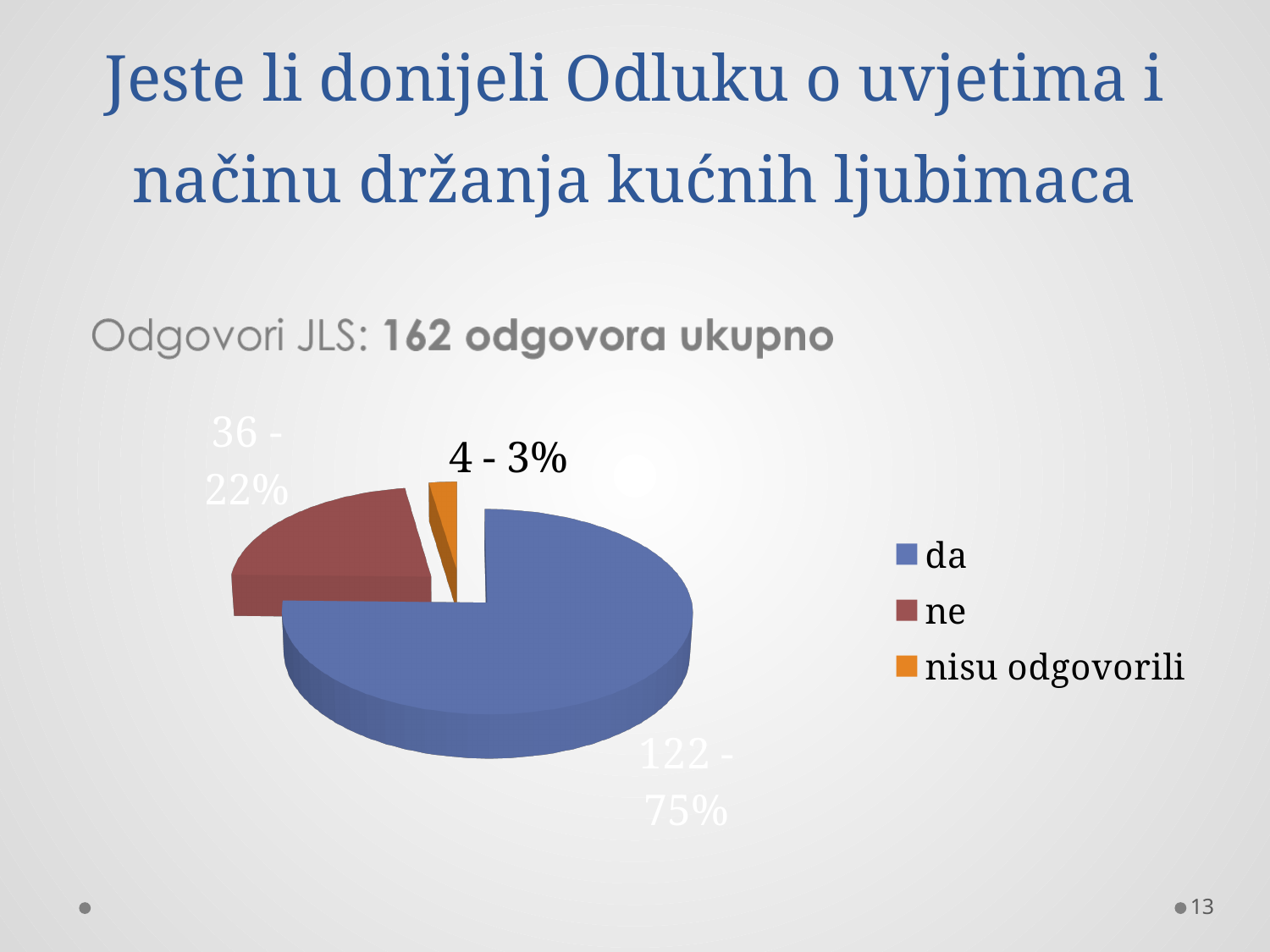
What colour is the 'nisu odgovorili' slice? orange Which is larger, the 'ne' slice or the 'nisu odgovorili' slice? ne What is the difference between the counts for 'da' and 'ne'? 86 Which category has the largest slice? da What kind of chart is shown on the slide? pie chart What is the count shown for the 'da' slice? 122 How many slices does the pie chart have? 3 What percentage is shown for the 'ne' slice? 22% How many entries does the legend list? 3 What is the count shown for the 'nisu odgovorili' slice? 4 Which category has the smallest slice? nisu odgovorili What percentage of the pie does the 'da' slice represent? 75%